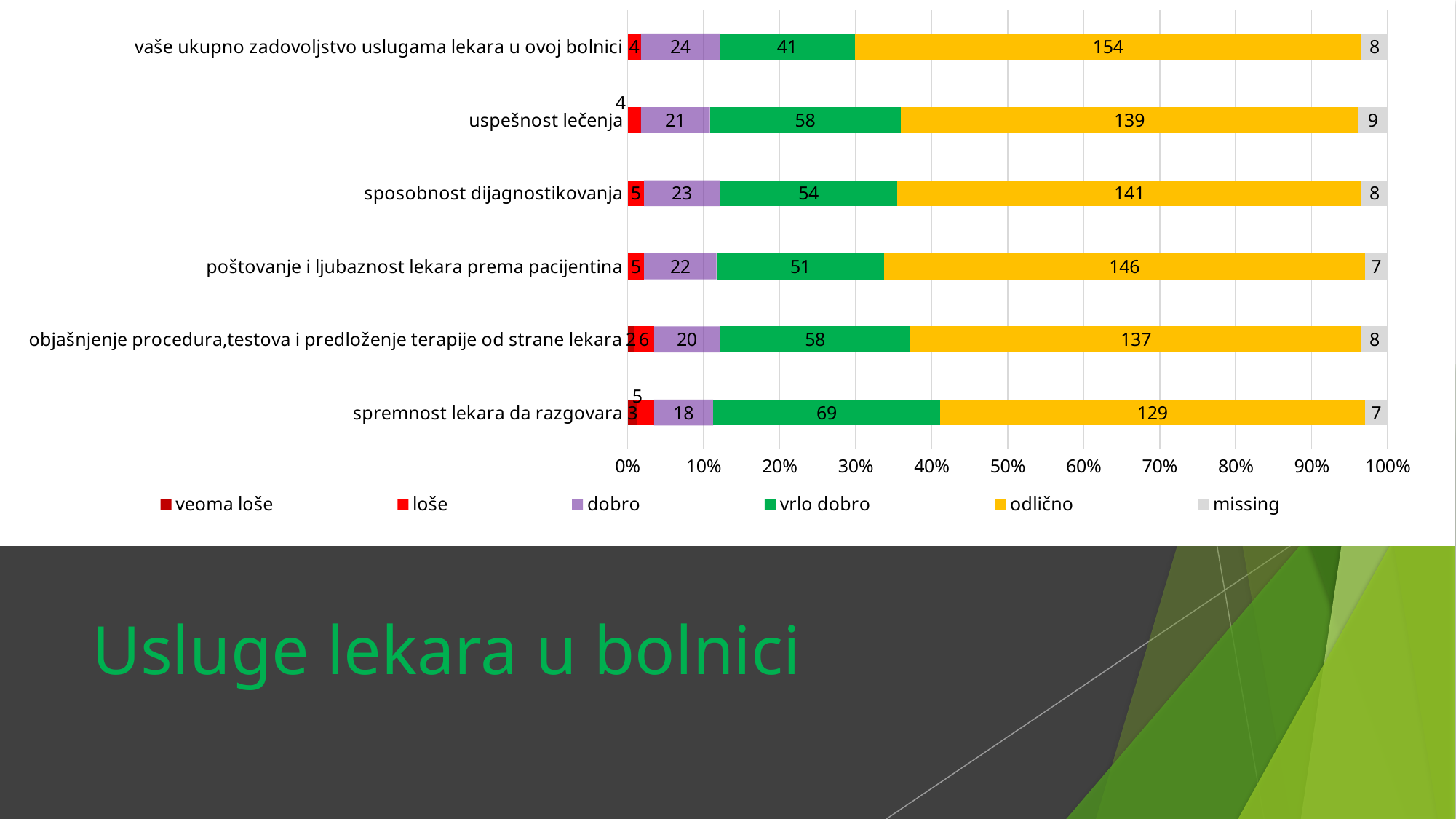
What kind of chart is shown on the slide? stacked bar chart What is the total of all labelled values in the bar for 'vaše ukupno zadovoljstvo uslugama lekara u ovoj bolnici'? 231 What is the difference between the 'odlično' values for 'sposobnost dijagnostikovanja' and 'uspešnost lečenja'? 2 How many series does the legend list? 6 What is the title shown on the slide? Usluge lekara u bolnici Which category has the highest 'odlično' value? vaše ukupno zadovoljstvo uslugama lekara u ovoj bolnici How many categories (survey items) are plotted on the chart? 6 What is the 'vrlo dobro' value for 'spremnost lekara da razgovara'? 69 Which has the larger 'vrlo dobro' value: 'uspešnost lečenja' or 'poštovanje i ljubaznost lekara prema pacijentina'? uspešnost lečenja What is the 'odlično' value for 'vaše ukupno zadovoljstvo uslugama lekara u ovoj bolnici'? 154 Which category has the lowest 'odlično' value? spremnost lekara da razgovara What is the 'missing' value for 'uspešnost lečenja'? 9